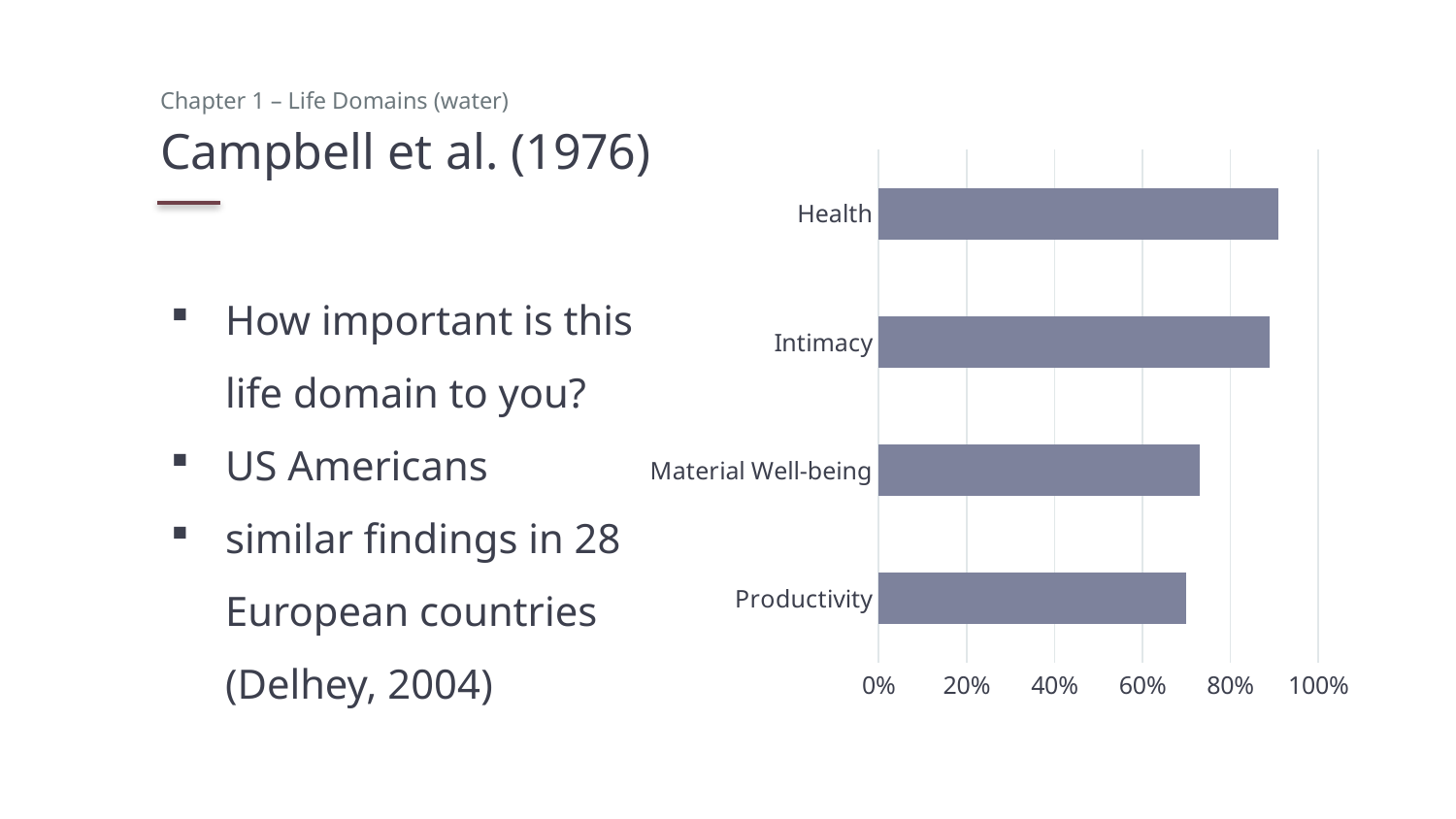
Is the value for Productivity greater or less than 80%? less Is the value for Intimacy greater or less than 80%? greater Is the value for Material Well-being greater or less than 80%? less What is the highest value shown on the chart's horizontal axis? 100% Which has the larger value, Intimacy or Productivity? Intimacy Which category is listed at the top of the bar chart? Health How many categories are plotted in the bar chart? 4 What kind of chart is shown on the slide? bar chart Which has the larger value, Health or Material Well-being? Health